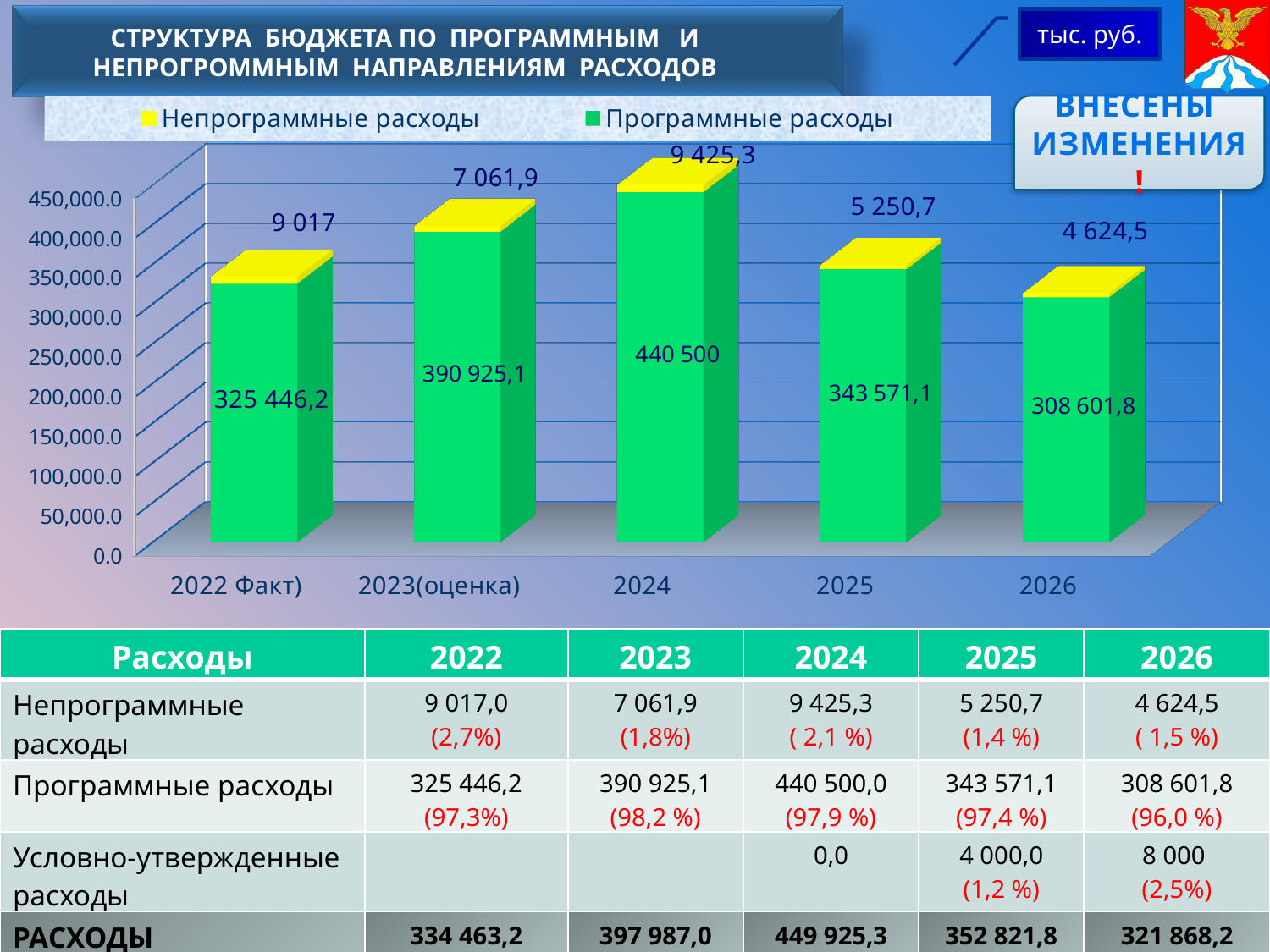
In which year are Непрограммные расходы lowest in the chart? 2026 What is the value of Непрограммные расходы for 2023(оценка) in the chart? 7 061,9 What is the value of Программные расходы for 2026 in the chart? 308 601,8 What is the value of Программные расходы for 2024 in the chart? 440 500 Do Программные расходы rise or fall from 2024 to 2026? fall How many series does the chart legend list? 2 Which is larger: Непрограммные расходы in 2022 Факт) or in 2025? 2022 Факт) What is the total of the stacked bar for 2022 Факт)? 334 463,2 What is the difference between Программные расходы in 2024 and in 2023(оценка)? 49 574,9 What kind of chart is shown on the slide? bar chart In which year are Программные расходы highest in the chart? 2024 How many categories (years) are shown on the x axis of the chart? 5